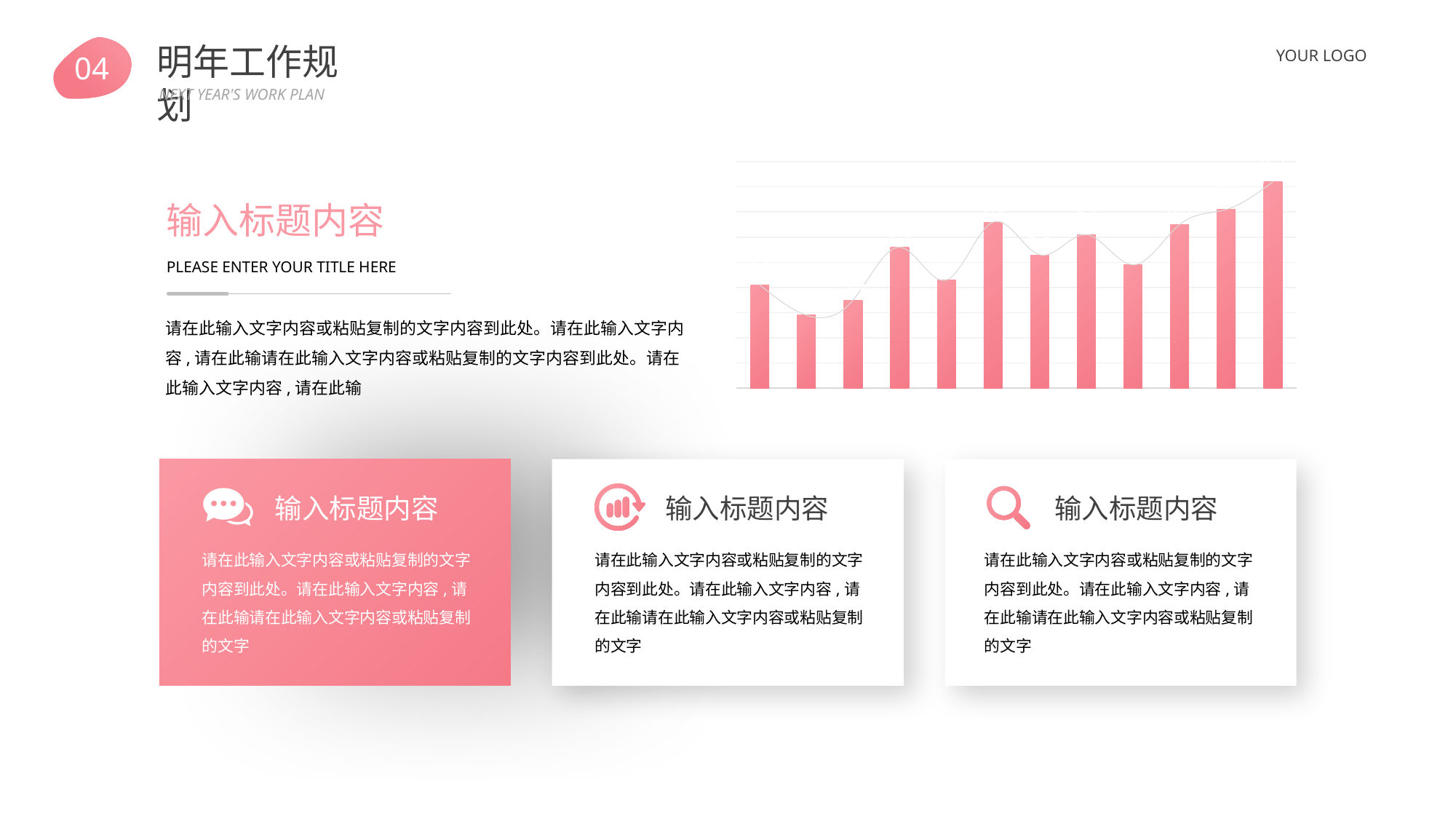
How many bars does the chart on the slide contain? 12 Is the ninth bar from the left taller or shorter than the tenth bar? shorter Is the sixth bar from the left taller or shorter than the seventh bar? taller Is the first bar from the left taller or shorter than the second bar? taller What kind of chart is shown on the slide? bar chart with a line overlay Overall, do the bar values rise or fall from left to right across the chart? rise Does the chart display a legend? No Which bar in the chart is the tallest? the rightmost (12th) bar Which bar in the chart is the shortest? the second bar from the left What colour are the bars in the chart? pink